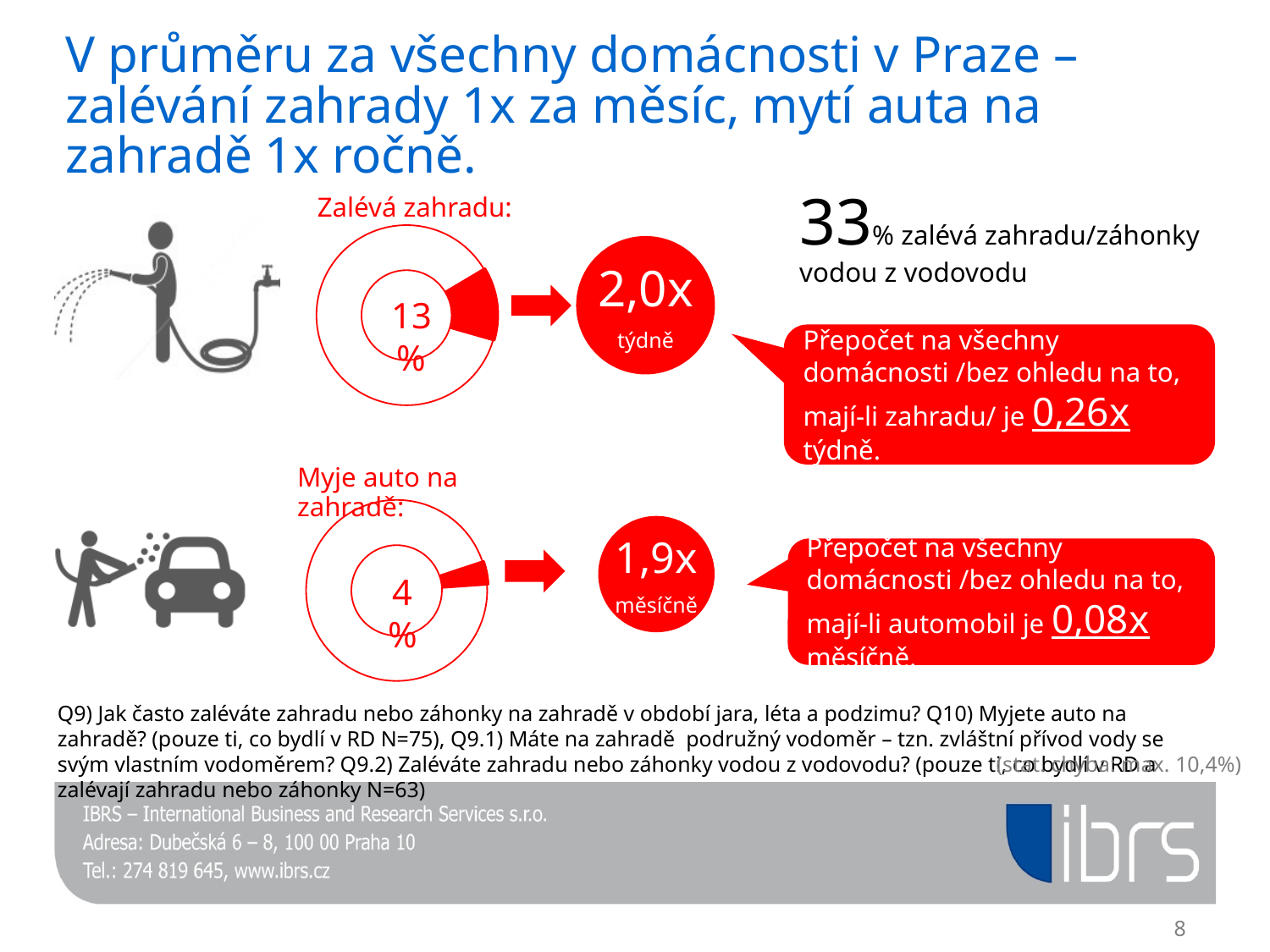
In the "Zalévá zahradu:" doughnut chart, what percentage is shown in the centre? 13 % In the "Zalévá zahradu:" doughnut chart, what share of the ring is not filled by the highlighted slice? 87 % In the "Myje auto na zahradě:" doughnut chart, what percentage is shown in the centre? 4 % What is the label above the upper doughnut chart? Zalévá zahradu: Which doughnut chart shows the larger percentage, "Zalévá zahradu:" or "Myje auto na zahradě:"? Zalévá zahradu: Which of the two doughnut charts shows the lowest percentage? Myje auto na zahradě: In the "Myje auto na zahradě:" doughnut chart, what share of the ring is not filled by the highlighted slice? 96 % What colour is the highlighted slice in the "Myje auto na zahradě:" doughnut chart? red What is the difference in percentage points between the "Zalévá zahradu:" value and the "Myje auto na zahradě:" value? 9 How many doughnut charts are on the slide? 2 What kind of chart is used for "Zalévá zahradu:"? doughnut chart